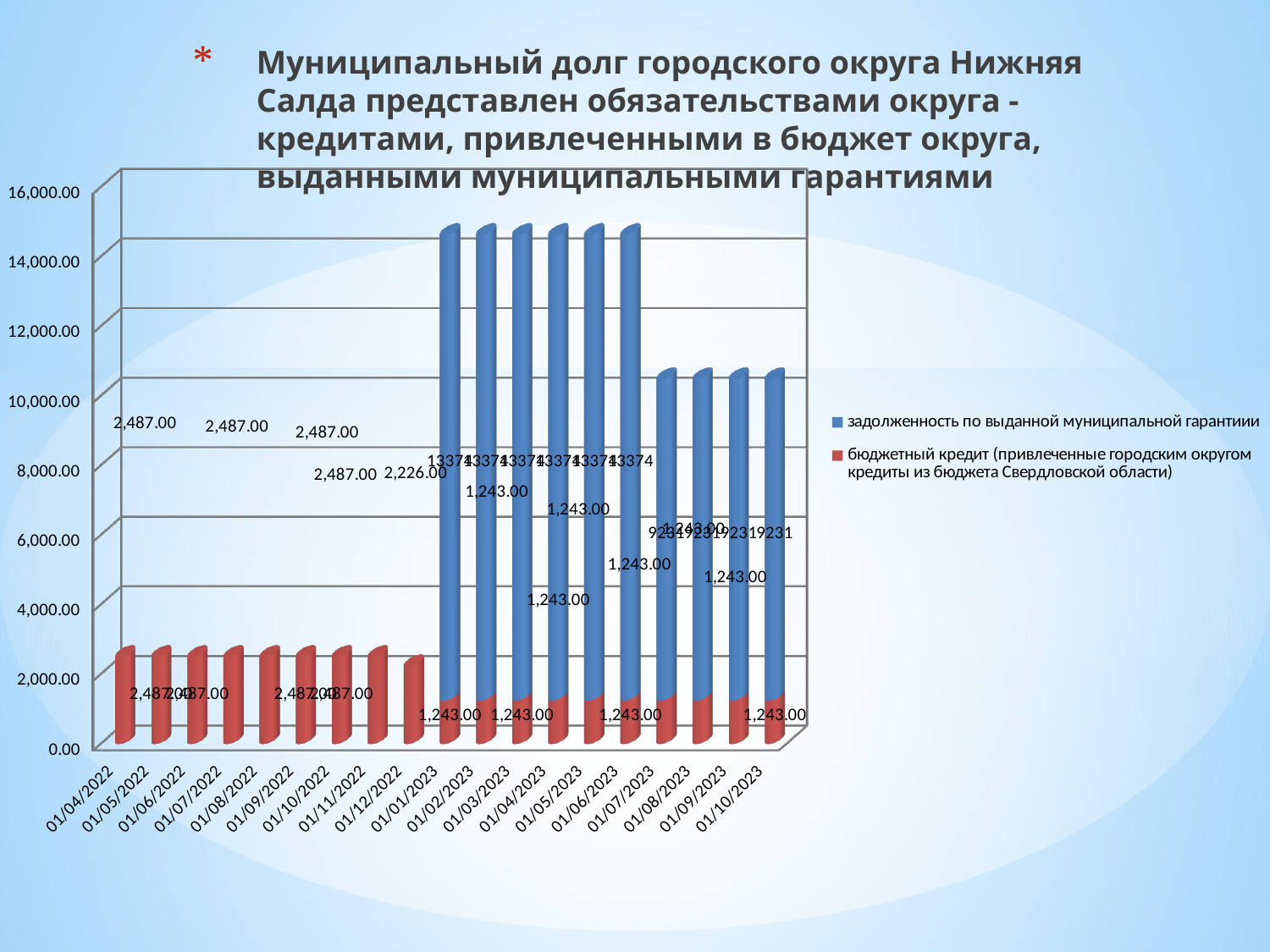
Is the total height of the stacked bar for 01/07/2023 greater or less than 12,000.00? less How many series does the legend list? 2 Is the total height of the stacked bar for 01/01/2023 greater or less than 14,000.00? greater How many dates are shown on the x axis? 19 What is the value of the задолженность по выданной муниципальной гарантиии series for 01/01/2023? 13374 What is the value of the бюджетный кредит series for 01/04/2022? 2,487.00 Does the задолженность по выданной муниципальной гарантиии series rise or fall from 01/06/2023 to 01/07/2023? fall What is the difference between the задолженность по выданной муниципальной гарантиии values for 01/06/2023 and 01/07/2023? 4143 What is the value of the бюджетный кредит series for 01/02/2023? 1,243.00 What is the value of the задолженность по выданной муниципальной гарантиии series for 01/10/2023? 9231 Which is larger for the задолженность по выданной муниципальной гарантиии series: the value for 01/03/2023 or the value for 01/08/2023? 01/03/2023 What kind of chart is shown on the slide? bar chart